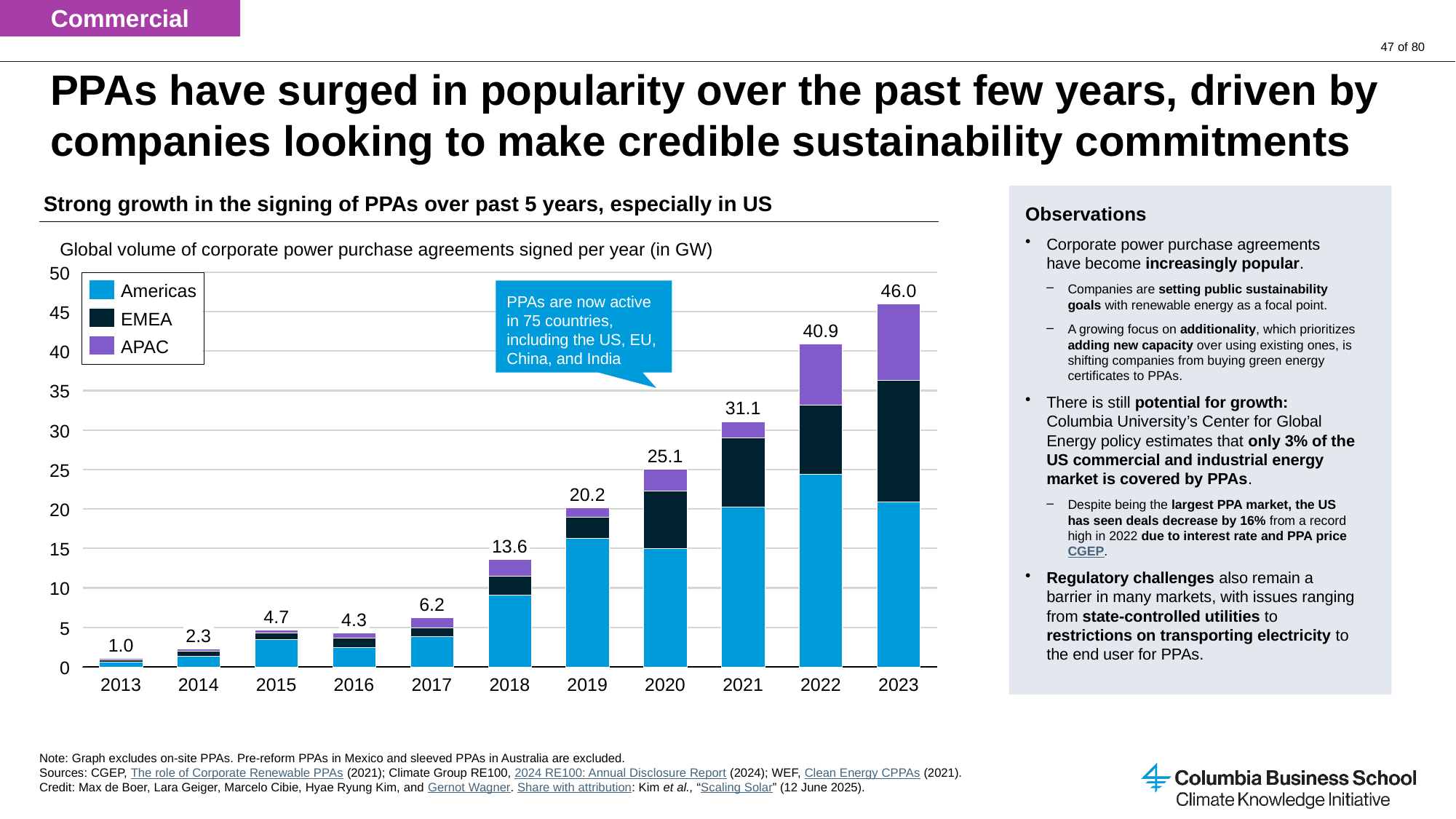
What kind of chart is shown on the slide? Stacked bar chart What is the total global volume of corporate PPAs signed in 2023? 46.0 Which year has the lowest total volume of PPAs signed? 2013 What is the total value shown for 2018? 13.6 How many years are shown on the x axis? 11 Do the total values generally rise or fall from 2013 to 2023? Rise What is the difference between the total for 2023 and the total for 2022? 5.1 Which year has a larger total, 2015 or 2016? 2015 Is the Americas value for 2022 greater or less than 20? greater Which year has the highest total volume of PPAs signed? 2023 What is the difference between the total for 2021 and the total for 2020? 6.0 How many series does the legend list? 3